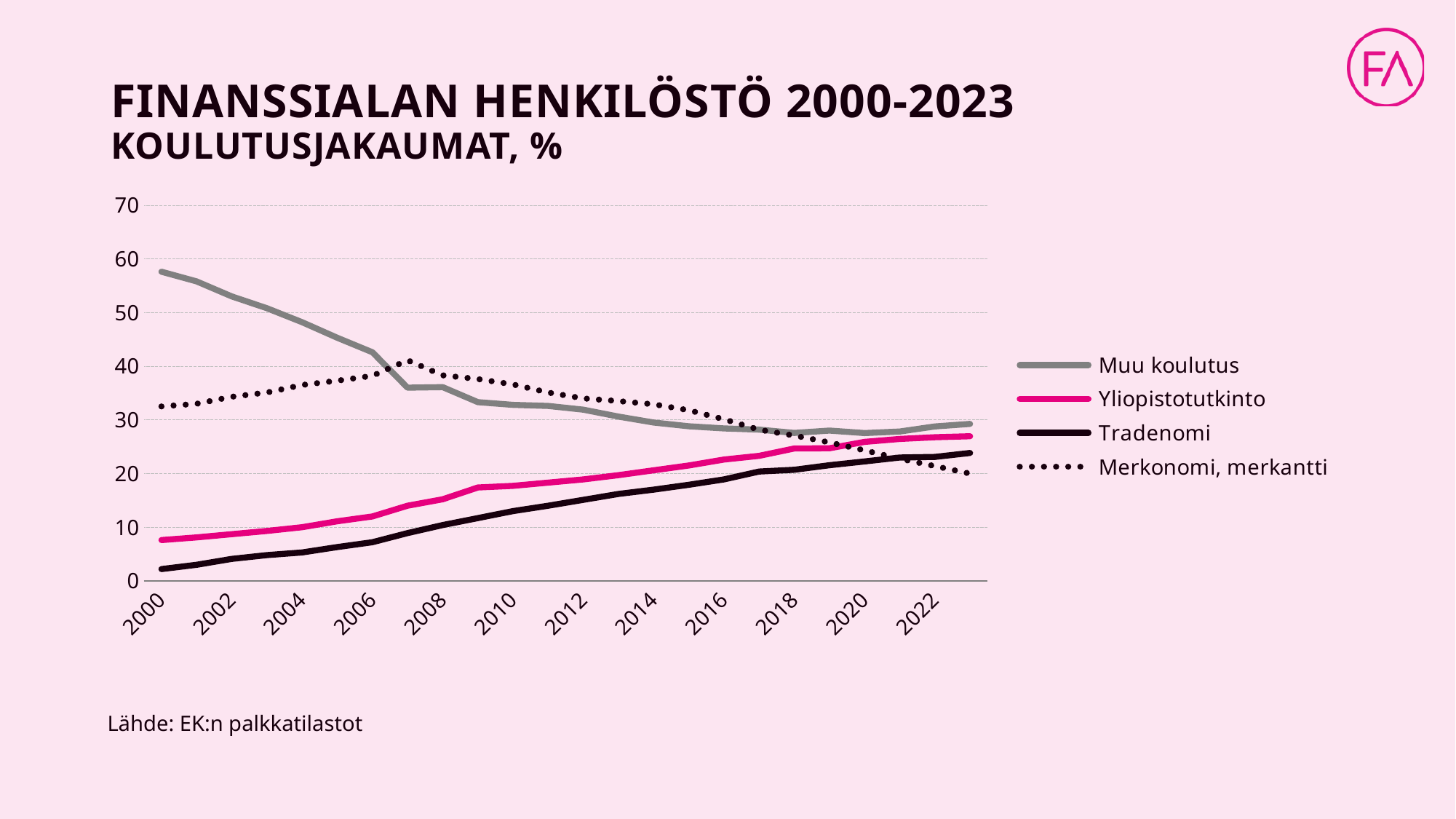
Is the value for Merkonomi, merkantti in 2023 greater or less than 30? less Does the Muu koulutus line rise or fall from 2000 to 2023? fall What kind of chart is shown on the slide? line chart Which series is drawn with a dotted line? Merkonomi, merkantti Is the value for Tradenomi in 2000 greater or less than 10? less In 2023, which is larger: Yliopistotutkinto or Merkonomi, merkantti? Yliopistotutkinto How many series does the legend list? 4 Which series has the lowest value in 2000? Tradenomi Does the Tradenomi line rise or fall from 2000 to 2023? rise What is the subtitle of the chart? KOULUTUSJAKAUMAT, % Which series has the highest value in 2000? Muu koulutus Is the value for Muu koulutus in 2000 greater or less than 50? greater